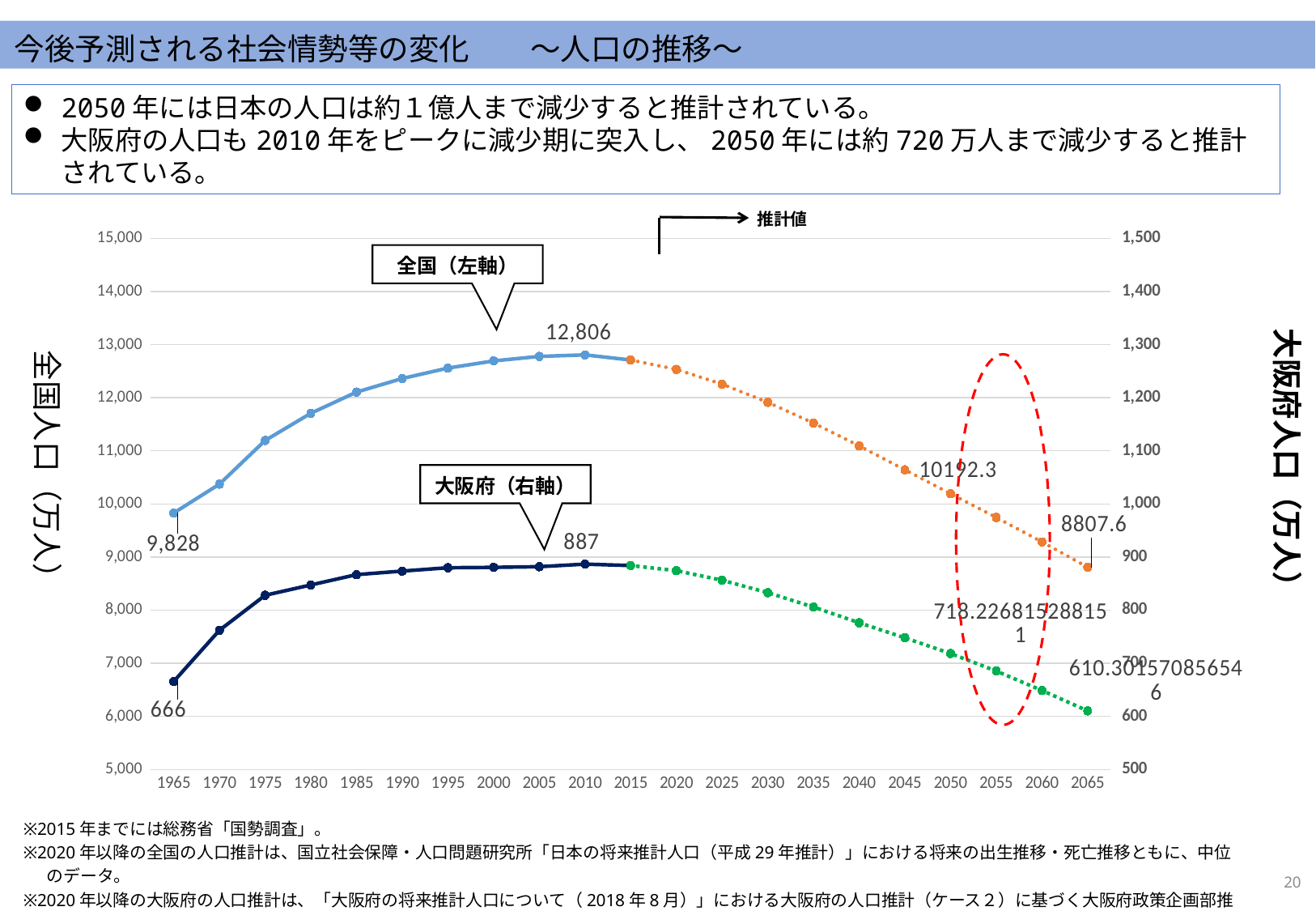
What kind of chart is shown on the slide? line chart What is the value for 大阪府 (Osaka population) in 1965? 666 What is the value for 全国 (national population) in 2010? 12,806 What is the value for 全国 (national population) in 1965? 9,828 By how much did the 全国 value increase from 1965 to 2010? 2,978 In which year does the 全国 series reach its highest value? 2010 What is the value for 全国 (national population) in 2050? 10192.3 What is the value for 大阪府 (Osaka population) in 2010? 887 By how much did the 大阪府 value increase from 1965 to 2010? 221 Is the value for 全国 in 2035 greater or less than 11,000? greater What is the value for 全国 (national population) in 2065? 8807.6 How many years are shown on the x axis? 21